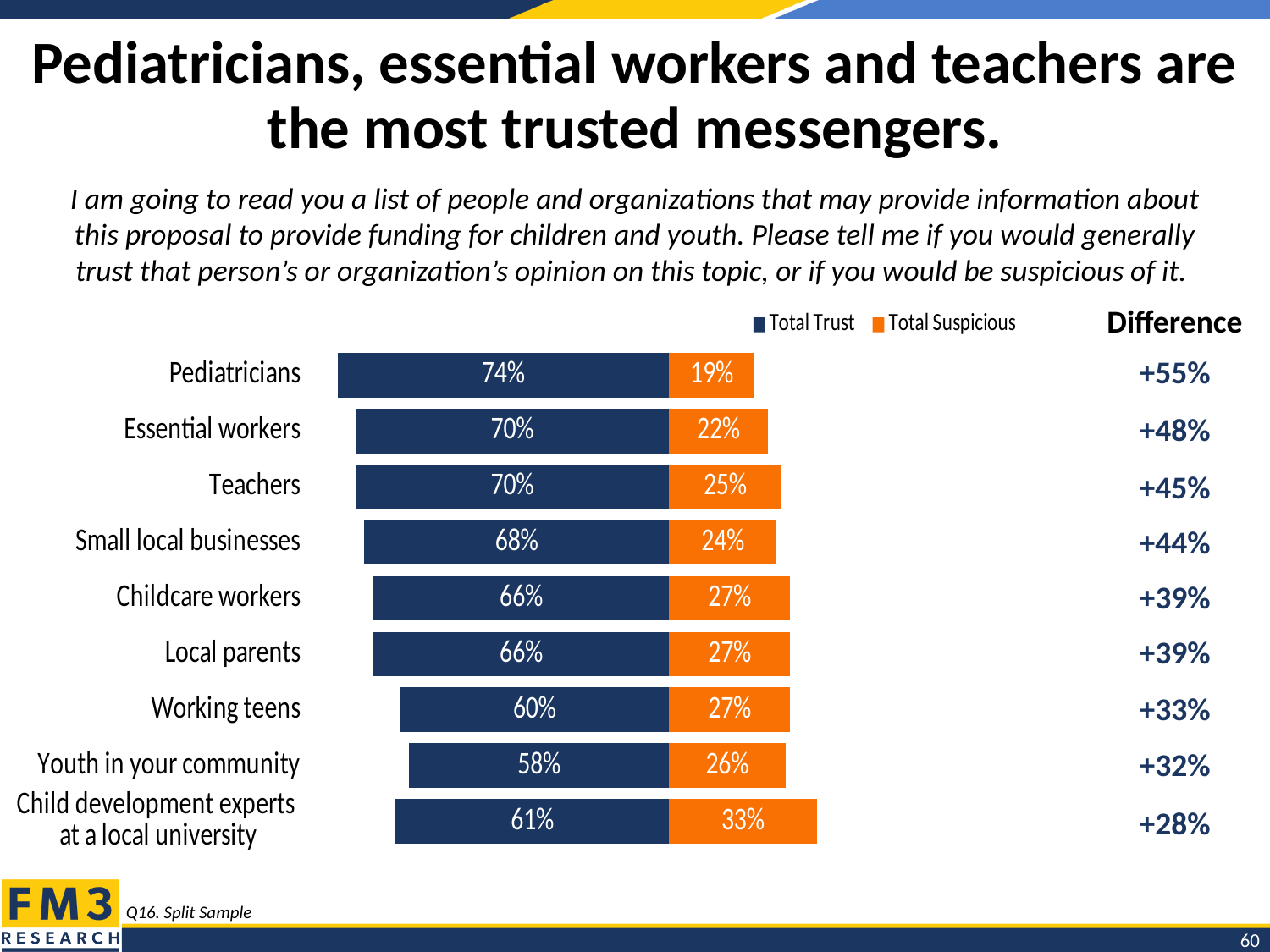
How many categories are shown in the chart? 9 Which category has the highest Total Trust value? Pediatricians How many series does the legend list? 2 What is the Total Trust value for Working teens? 60% Which series is shown in orange in the legend? Total Suspicious What is the Total Suspicious value for Child development experts at a local university? 33% What kind of chart is shown on the slide? Bar chart Which category has the lowest Total Trust value? Youth in your community Which category has the lowest Total Suspicious value? Pediatricians Which is larger: the Total Trust value for Small local businesses or the Total Trust value for Childcare workers? Small local businesses What is the Total Trust value for Pediatricians? 74% What is the difference between the Total Trust and Total Suspicious values for Teachers? +45%